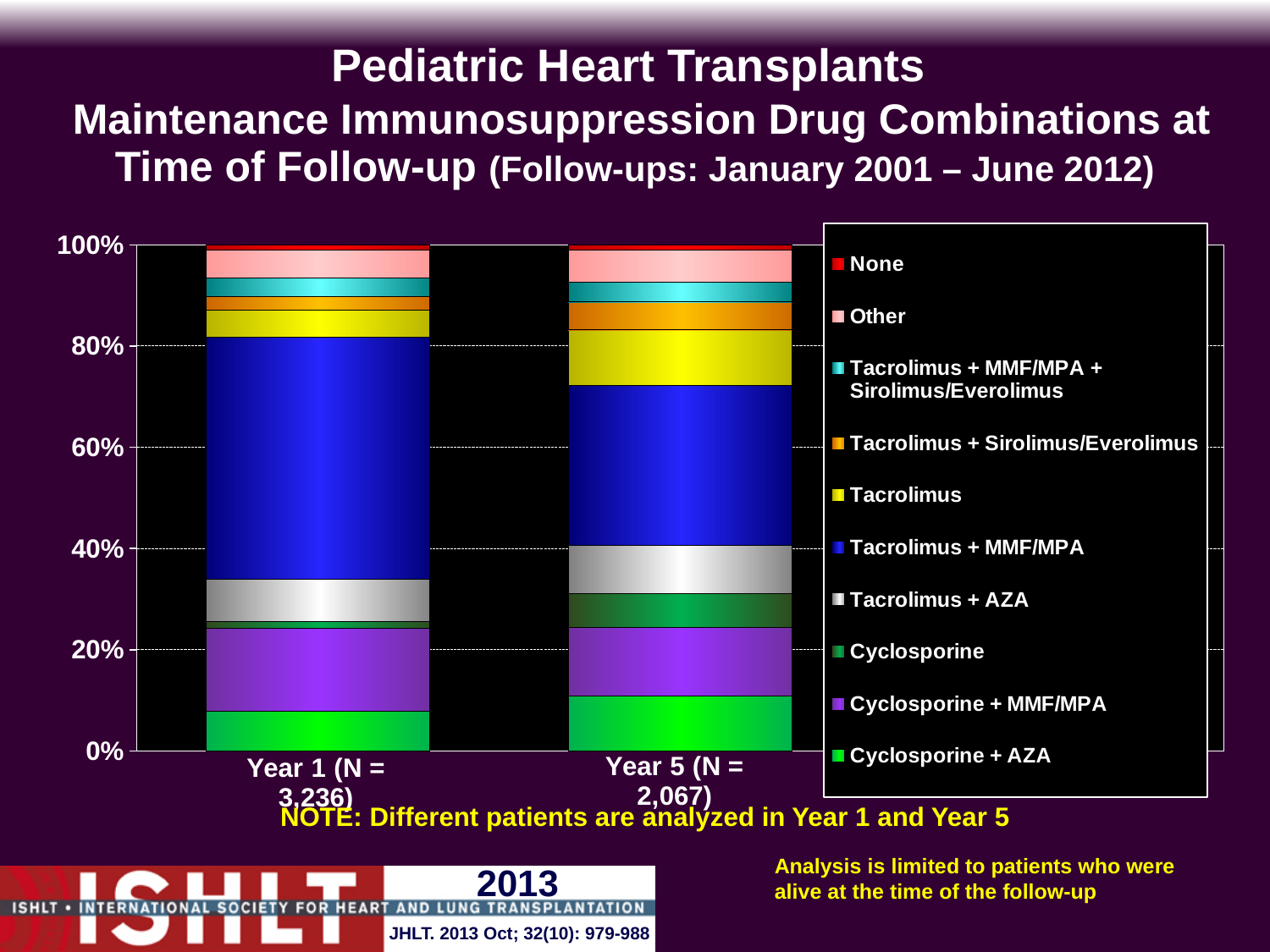
Is the Tacrolimus + MMF/MPA share in Year 1 greater or less than 40%? greater Which bar has the larger Tacrolimus + MMF/MPA segment, Year 1 or Year 5? Year 1 How many bars (follow-up time points) are plotted in the chart? 2 Is the Cyclosporine + AZA share in Year 1 greater or less than 20%? less What kind of chart is shown on the slide? Stacked bar chart Which bar has the larger Tacrolimus (alone) segment, Year 1 or Year 5? Year 5 How many drug combination series does the legend list? 10 Is the Tacrolimus + MMF/MPA share in Year 5 greater or less than 40%? less Which drug combination makes up the largest segment of the Year 1 bar? Tacrolimus + MMF/MPA What is the N shown for the Year 1 bar? 3,236 Which bar has the larger Cyclosporine + AZA segment, Year 1 or Year 5? Year 5 Which legend entry is listed last (at the bottom of the legend)? Cyclosporine + AZA